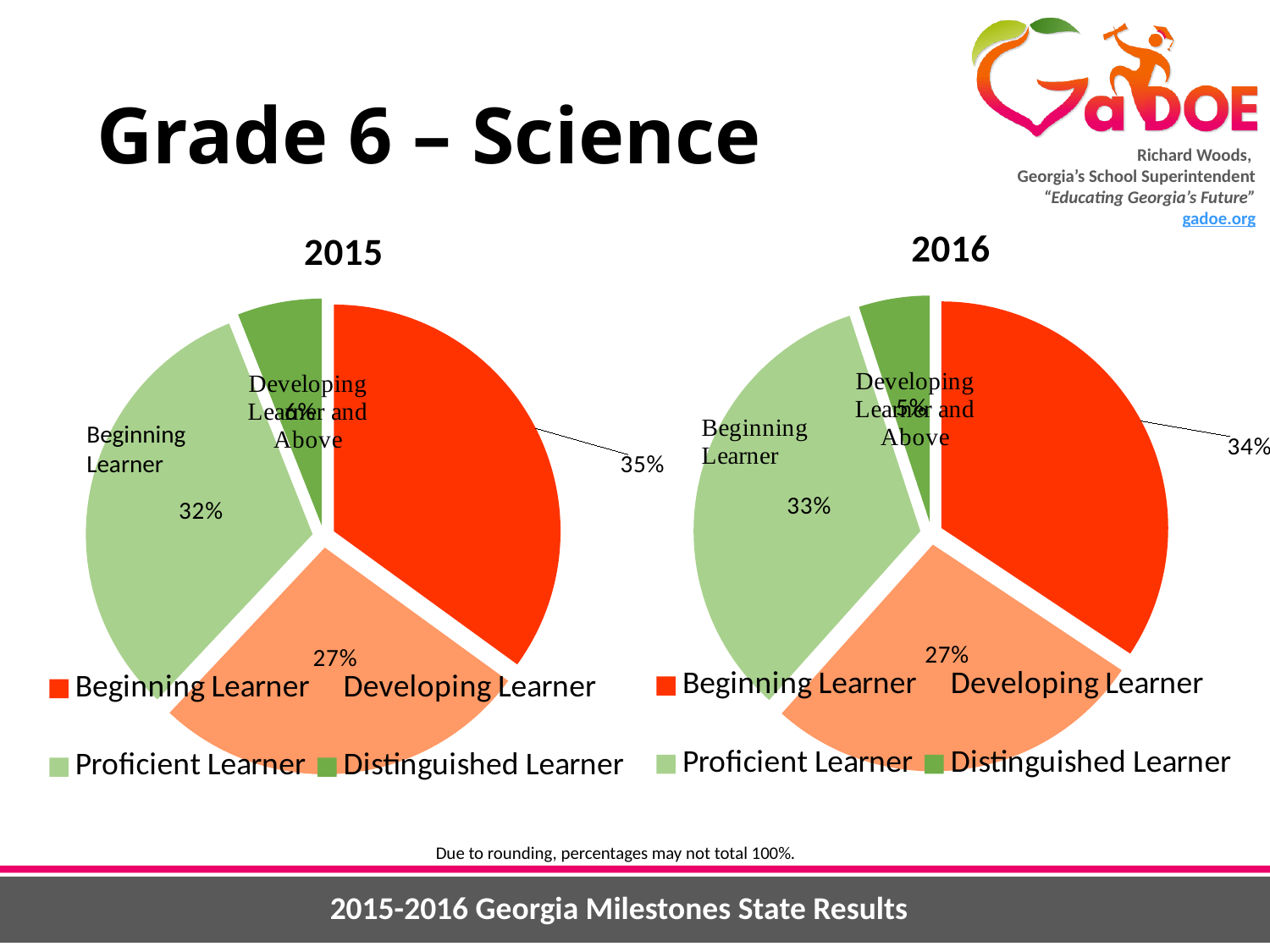
What kind of chart is the 2015 chart? Pie chart How many entries does the legend of the 2015 chart list? 4 In the 2016 chart, which category has the smallest slice? Distinguished Learner In the 2015 chart, what percentage is shown for Developing Learner? 27% According to the legend, what colour represents Beginning Learner? Red In the 2016 chart, what percentage is shown for Developing Learner? 27% In the 2016 chart, what percentage is shown for Distinguished Learner? 5% In the 2015 chart, which is larger: Developing Learner or Distinguished Learner? Developing Learner How many slices does the 2016 pie chart have? 4 In the 2015 chart, what percentage is shown for Distinguished Learner? 6% What is the difference between the Distinguished Learner percentage in 2015 and in 2016? 1 percentage point In the 2015 chart, what is the percentage of the largest slice? 35%